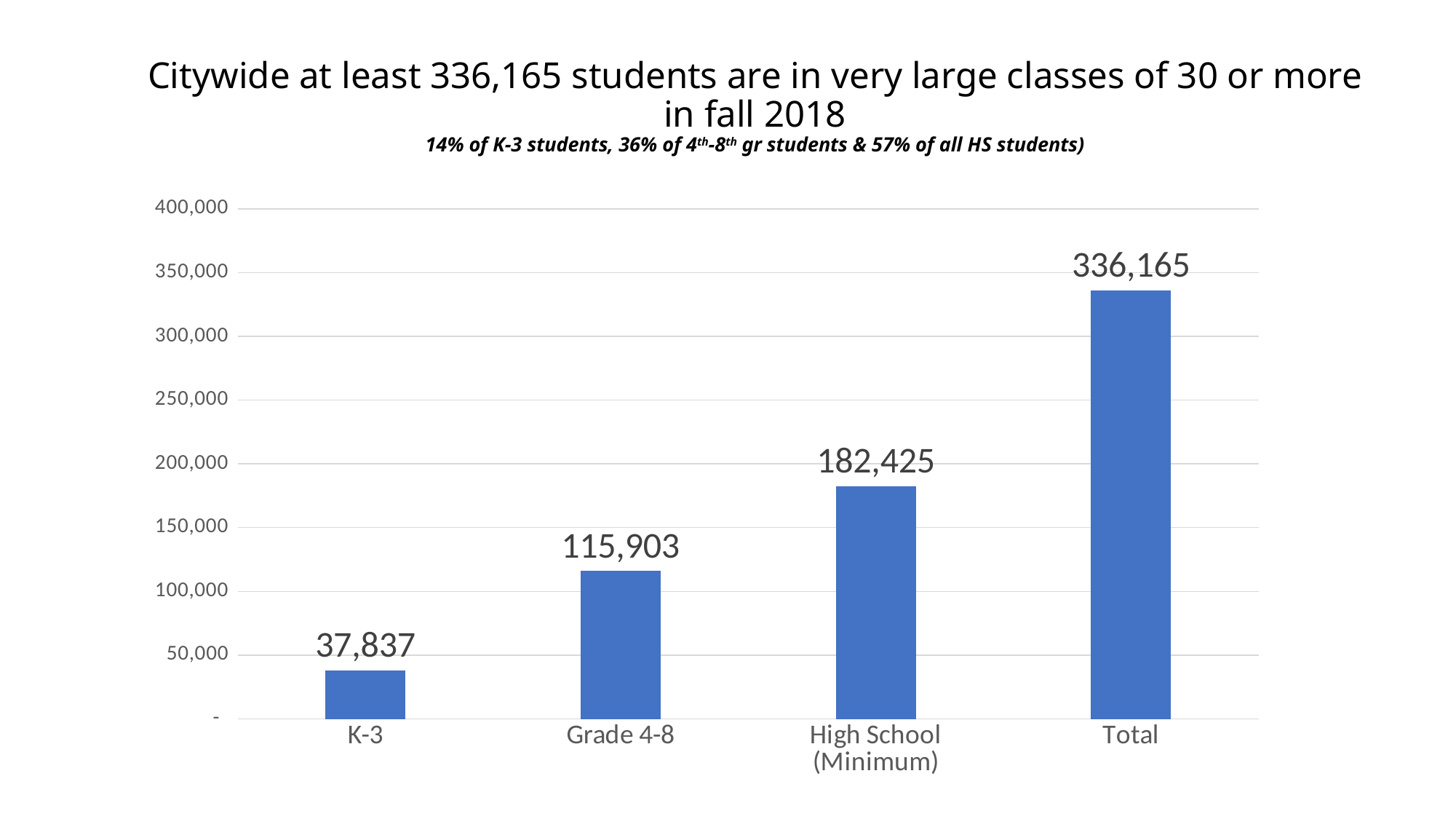
What is the difference between the values for High School (Minimum) and Grade 4-8? 66,522 What is the value for K-3? 37,837 What kind of chart is shown on the slide? bar chart Is the value for High School (Minimum) greater or less than 200,000? less Which is larger, the value for Grade 4-8 or the value for K-3? Grade 4-8 Which category has the highest value? Total What is the value for High School (Minimum)? 182,425 How many categories are shown on the x axis? 4 What is the value for Total? 336,165 What is the value for Grade 4-8? 115,903 Do the values rise or fall from left to right along the x axis? rise Which category has the lowest value? K-3